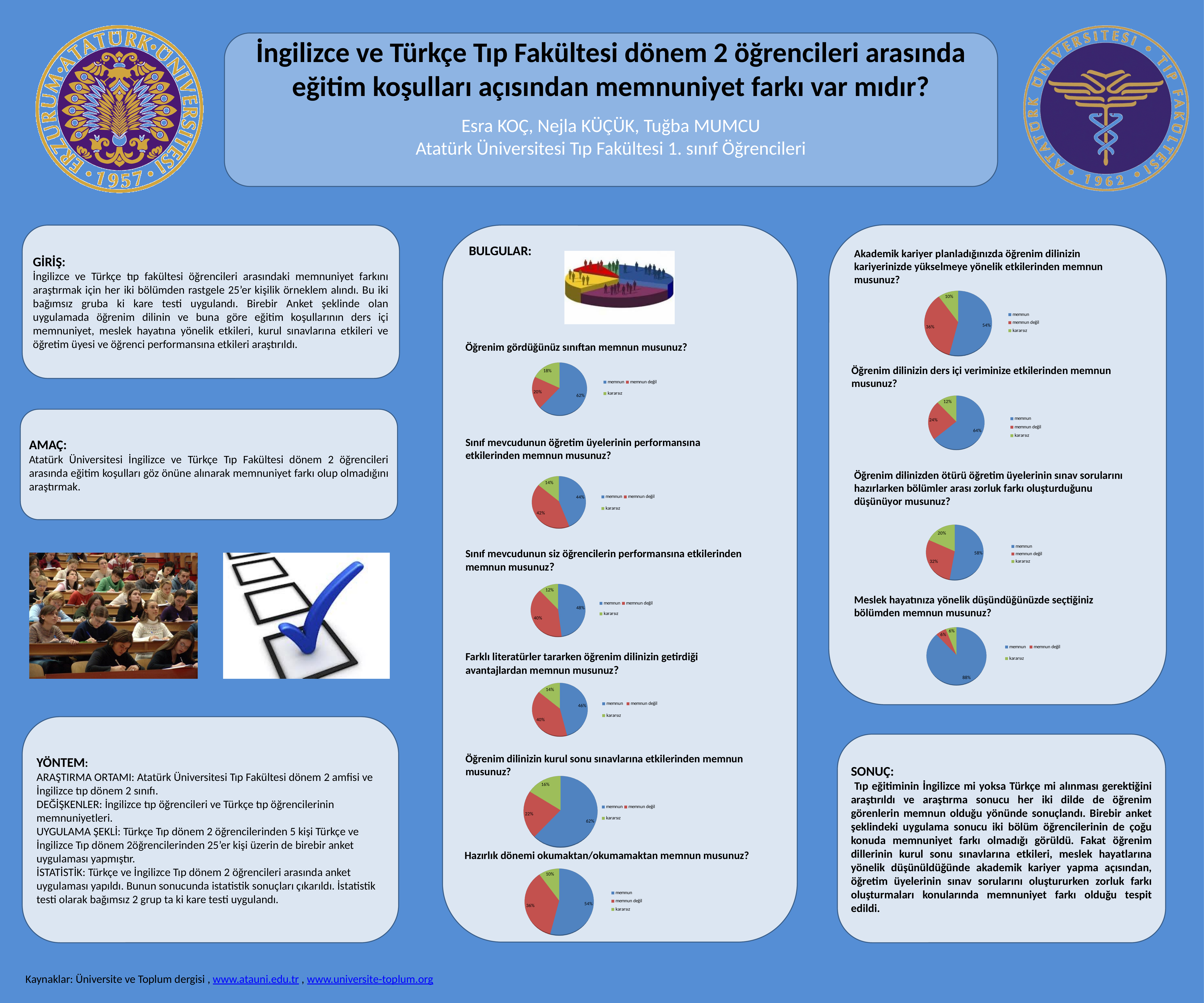
In the pie chart titled "Sınıf mevcudunun siz öğrencilerin performansına etkilerinden memnun musunuz?", what is the difference between the "memnun" and "memnun değil" shares? 8% How many categories does the legend list in the pie chart titled "Öğrenim gördüğünüz sınıftan memnun musunuz?"? 3 In the pie chart titled "Akademik kariyer planladığınızda öğrenim dilinizin kariyerinizde yükselmeye yönelik etkilerinden memnun musunuz?", what share is labelled for "memnun"? 54% In the pie chart titled "Sınıf mevcudunun öğretim üyelerinin performansına etkilerinden memnun musunuz?", what is the share for "memnun değil"? 42% In the pie chart titled "Öğrenim dilinizin ders içi veriminize etkilerinden memnun musunuz?", which category has the largest share? memnun In the pie chart titled "Meslek hayatınıza yönelik düşündüğünüzde seçtiğiniz bölümden memnun musunuz?", what share is labelled for "memnun"? 88% What type of chart is used for "Hazırlık dönemi okumaktan/okumamaktan memnun musunuz?"? Pie chart In the pie chart titled "Öğrenim dilinizin kurul sonu sınavlarına etkilerinden memnun musunuz?", which is larger, "memnun değil" or "kararsız"? memnun değil In the pie chart titled "Farklı literatürler tararken öğrenim dilinizin getirdiği avantajlardan memnun musunuz?", what share is labelled for "kararsız"? 14% In the pie chart titled "Hazırlık dönemi okumaktan/okumamaktan memnun musunuz?", what is the share for "memnun değil"? 36% In the pie chart titled "Öğrenim gördüğünüz sınıftan memnun musunuz?", what share is labelled for "memnun"? 62% In the pie chart titled "Öğrenim gördüğünüz sınıftan memnun musunuz?", which category has the smallest share? kararsız